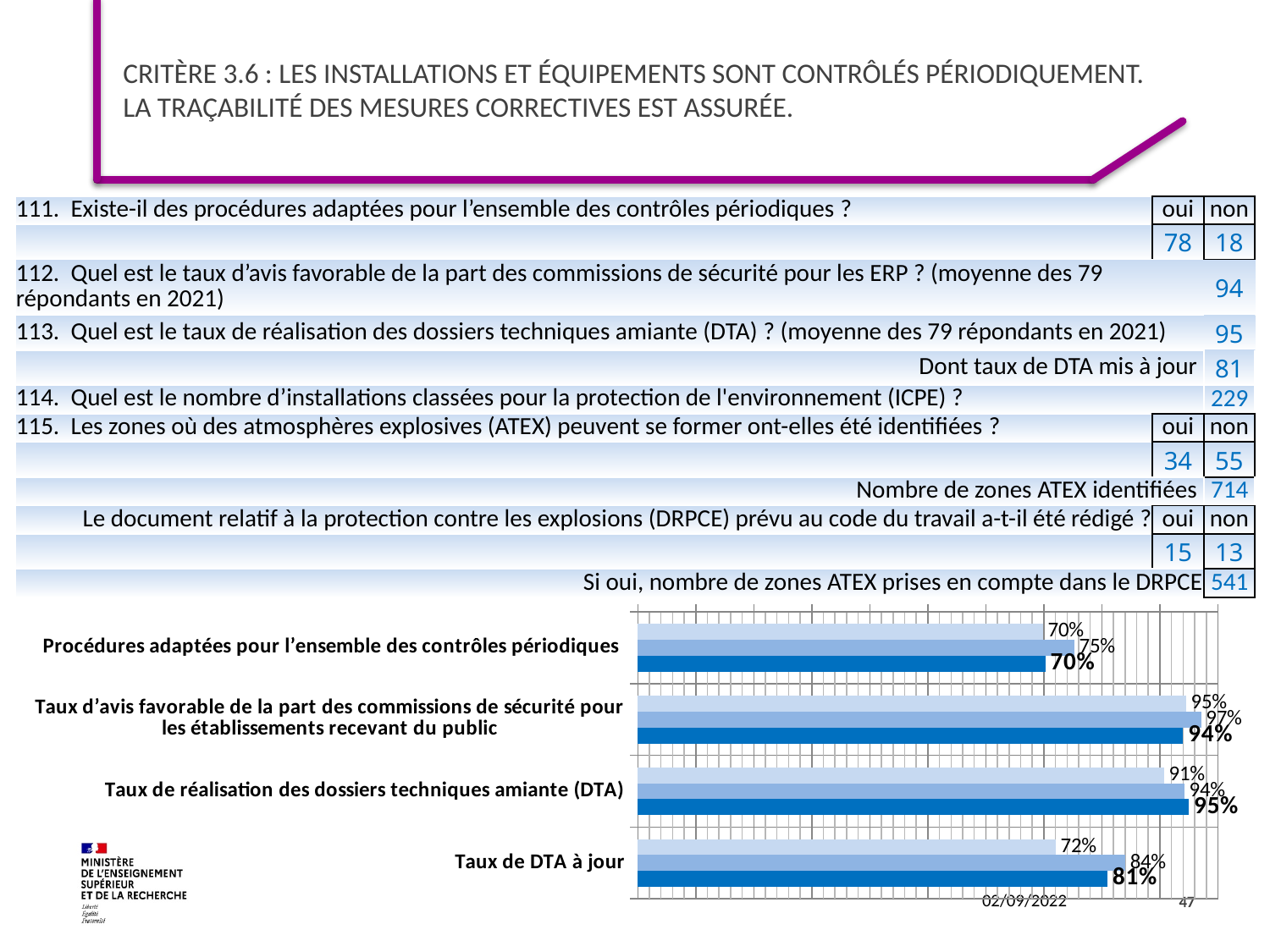
How many bars are plotted for each category in the bar chart? 3 What kind of chart is shown at the bottom of the slide? bar chart In the bar chart, what is the value of the dark blue (bottom) bar for 'Taux de DTA à jour'? 81% In the bar chart, what is the value of the middle bar for 'Taux d'avis favorable de la part des commissions de sécurité pour les établissements recevant du public'? 97% Among the dark blue (bottom) bars in the bar chart, which category has the lowest value? Procédures adaptées pour l'ensemble des contrôles périodiques In the bar chart, what is the difference between the middle bar and the dark blue (bottom) bar for 'Taux de DTA à jour'? 3% How many categories does the bar chart show? 4 In the bar chart, what is the value of the light blue (top) bar for 'Procédures adaptées pour l'ensemble des contrôles périodiques'? 70% Among the dark blue (bottom) bars in the bar chart, which category has the highest value? Taux de réalisation des dossiers techniques amiante (DTA) In the bar chart, what is the difference between the light blue (top) bar and the middle bar for 'Taux de DTA à jour'? 12% In the bar chart, for 'Taux de réalisation des dossiers techniques amiante (DTA)', which is larger: the light blue (top) bar or the dark blue (bottom) bar? the dark blue (bottom) bar In the bar chart, what is the value of the dark blue (bottom) bar for 'Taux de réalisation des dossiers techniques amiante (DTA)'? 95%